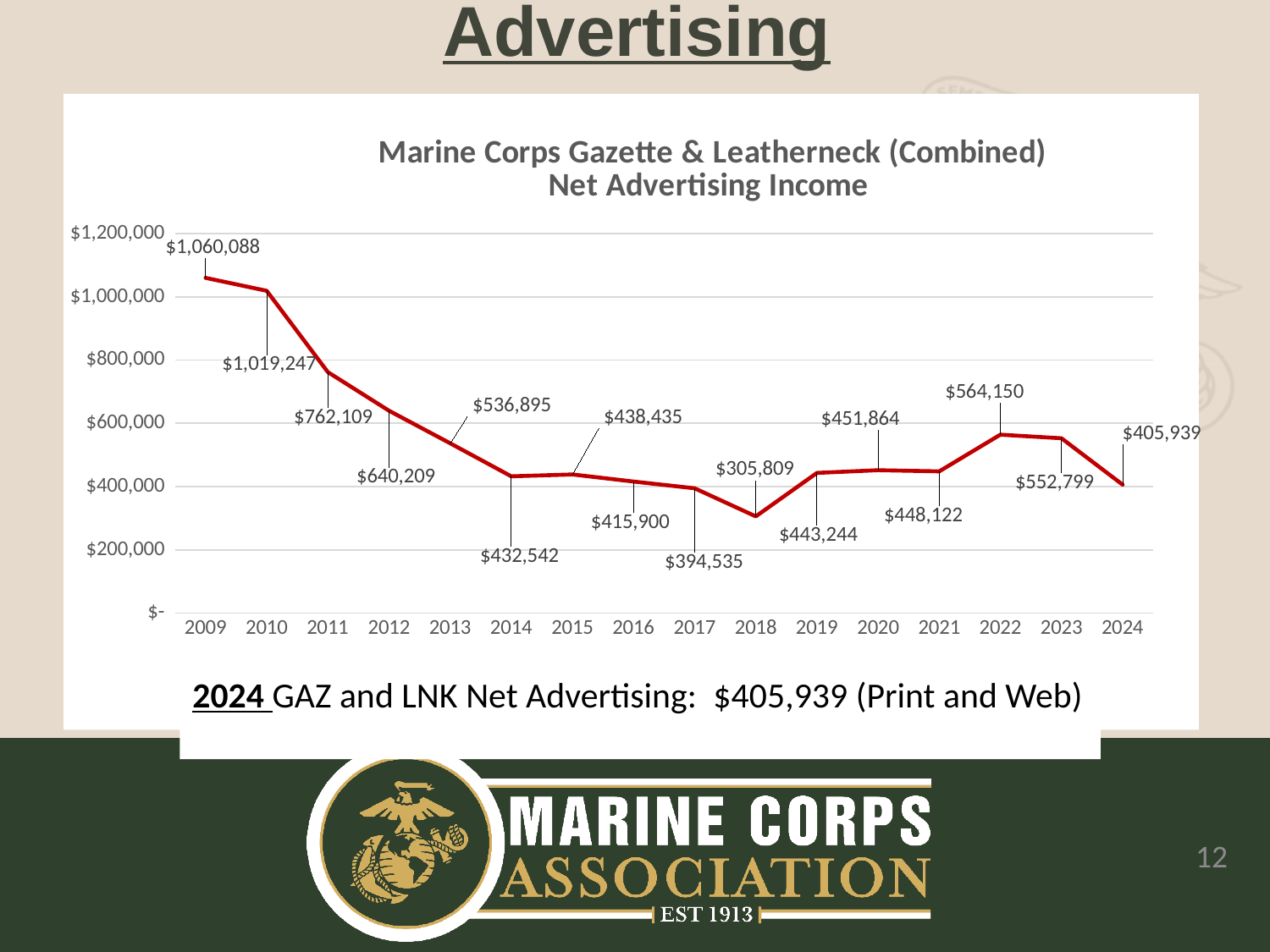
Which year had higher net advertising income, 2022 or 2024? 2022 What was the net advertising income in 2024? $405,939 Did net advertising income generally rise or fall from 2009 to 2018? Fall How many years are plotted on the chart? 16 What was the net advertising income in 2018? $305,809 Which year had the lowest net advertising income? 2018 How much higher was net advertising income in 2009 than in 2024? $654,149 What type of chart is shown on the slide? Line chart Which year had the highest net advertising income? 2009 What is the difference between the 2022 and 2023 net advertising income values? $11,351 What was the net advertising income in 2009? $1,060,088 What was the net advertising income in 2022? $564,150